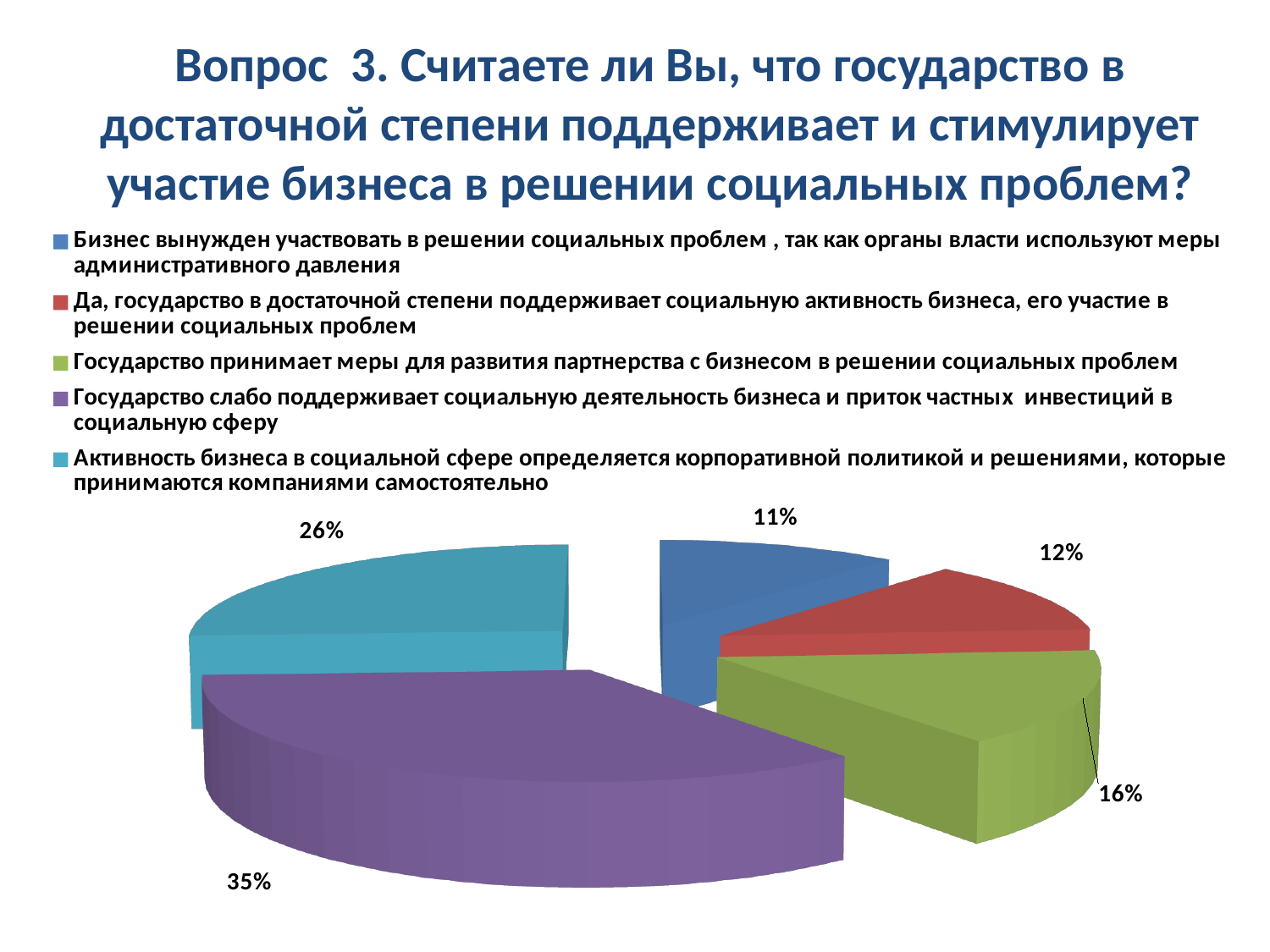
What kind of chart is shown on the slide? Pie chart What share of respondents chose "Государство слабо поддерживает социальную деятельность бизнеса и приток частных инвестиций в социальную сферу"? 35% Which answer option has the largest share in the pie chart? Государство слабо поддерживает социальную деятельность бизнеса и приток частных инвестиций в социальную сферу How many slices does the pie chart have? 5 Which answer option has the smallest share in the pie chart? Бизнес вынужден участвовать в решении социальных проблем, так как органы власти используют меры административного давления What share of respondents chose "Да, государство в достаточной степени поддерживает социальную активность бизнеса, его участие в решении социальных проблем"? 12% Which share is larger: "Да, государство в достаточной степени поддерживает социальную активность бизнеса..." or "Государство принимает меры для развития партнерства с бизнесом..."? Государство принимает меры для развития партнерства с бизнесом в решении социальных проблем What is the difference in percentage points between the largest slice (35%) and the second largest slice (26%)? 9 percentage points What share of respondents chose "Государство принимает меры для развития партнерства с бизнесом в решении социальных проблем"? 16% What share of respondents chose "Бизнес вынужден участвовать в решении социальных проблем, так как органы власти используют меры административного давления"? 11% What share of respondents chose "Активность бизнеса в социальной сфере определяется корпоративной политикой и решениями, которые принимаются компаниями самостоятельно"? 26% What colour is the largest slice of the pie chart? Purple